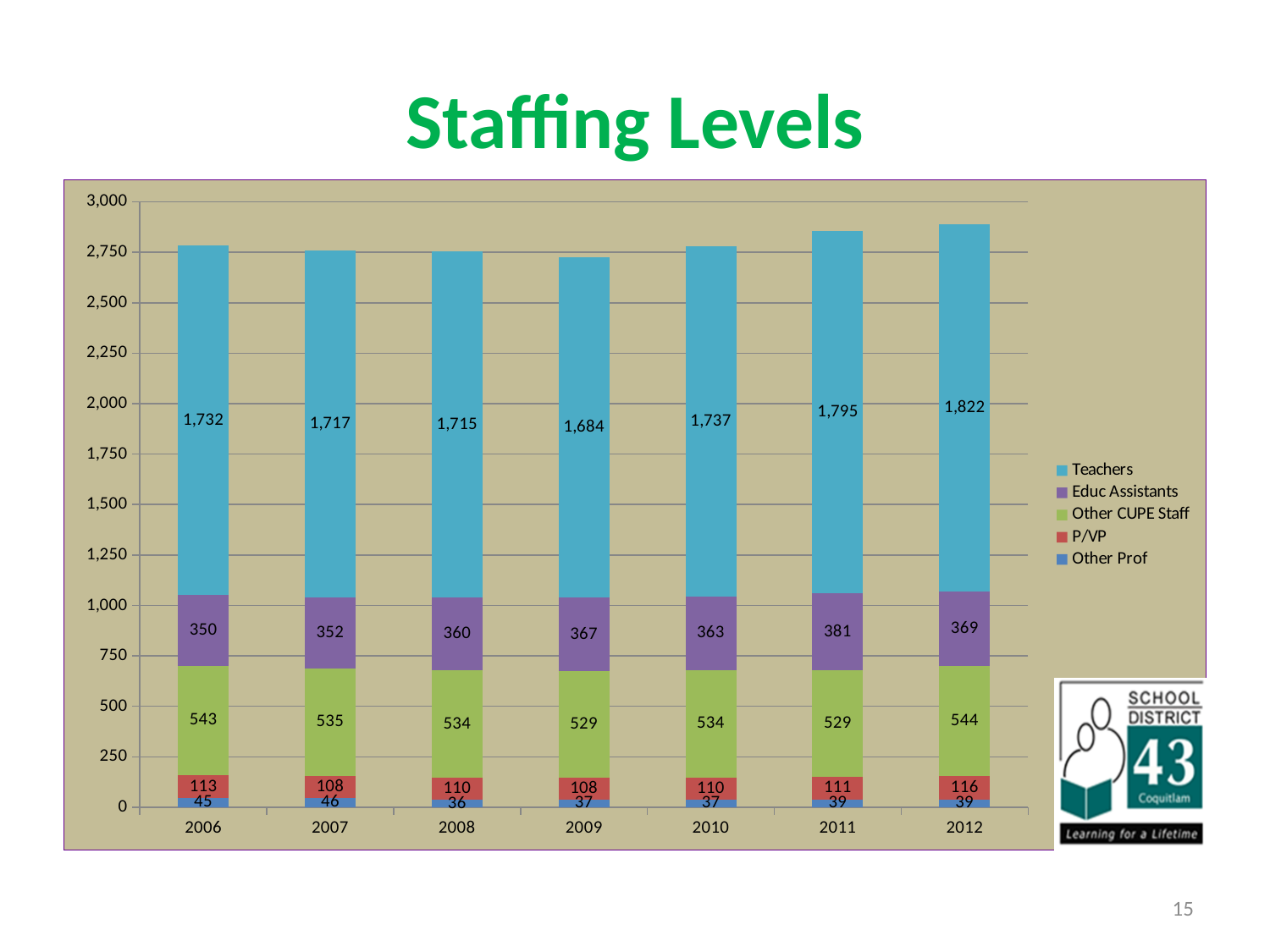
What type of chart is shown on the slide? Stacked bar chart What is the P/VP value in 2006? 113 What is the number of Educ Assistants in 2011? 381 What is the difference in the number of Teachers between 2012 and 2009? 138 What is the value for Other CUPE Staff in 2009? 529 In which year is the number of Teachers lowest? 2009 Which is larger, the Other Prof value in 2007 or in 2008? 2007 How many years are shown on the x axis? 7 What is the number of Teachers in 2012? 1,822 What is the total staffing level for 2012 (sum of all segments)? 2,890 How many series does the legend list? 5 In which year is the number of Teachers highest? 2012